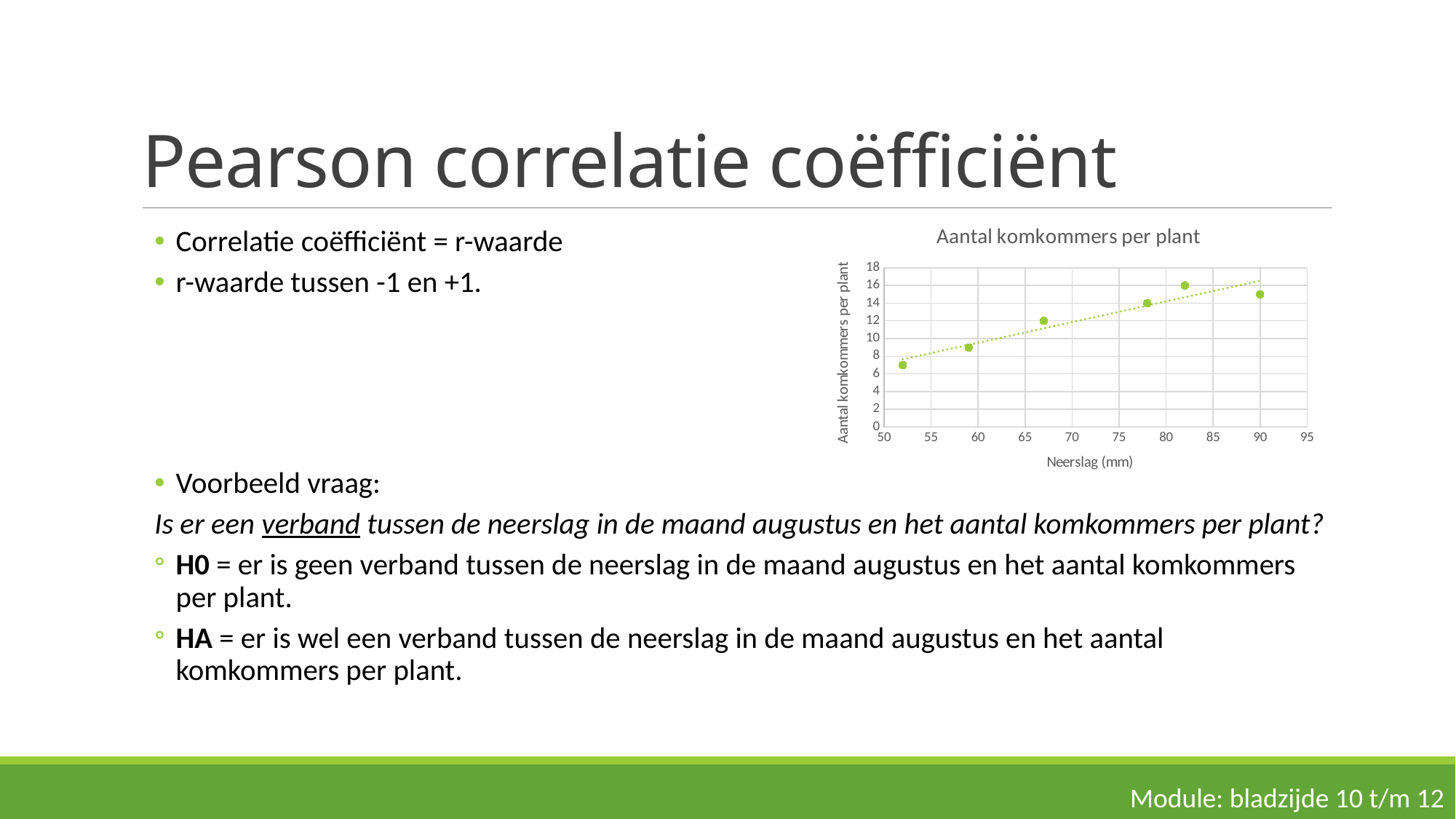
Is the value for the leftmost point (around 52 mm) greater or less than 8? less Is the value for the point at around 59 mm greater or less than 10? less What is the title of the chart? Aantal komkommers per plant What is the highest value shown on the y axis of the chart? 18 How many data points are plotted in the chart? 6 What is the label of the x axis of the chart? Neerslag (mm) Do the values in the chart generally rise or fall as Neerslag (mm) increases? rise Which point has the lowest number of komkommers per plant: the one at around 52 mm or the one at around 90 mm? the one at around 52 mm What kind of chart is shown on the slide? scatter chart Is the value for the point at around 67 mm greater or less than 10? greater Which point is higher: the one at around 82 mm or the one at around 90 mm? the one at around 82 mm